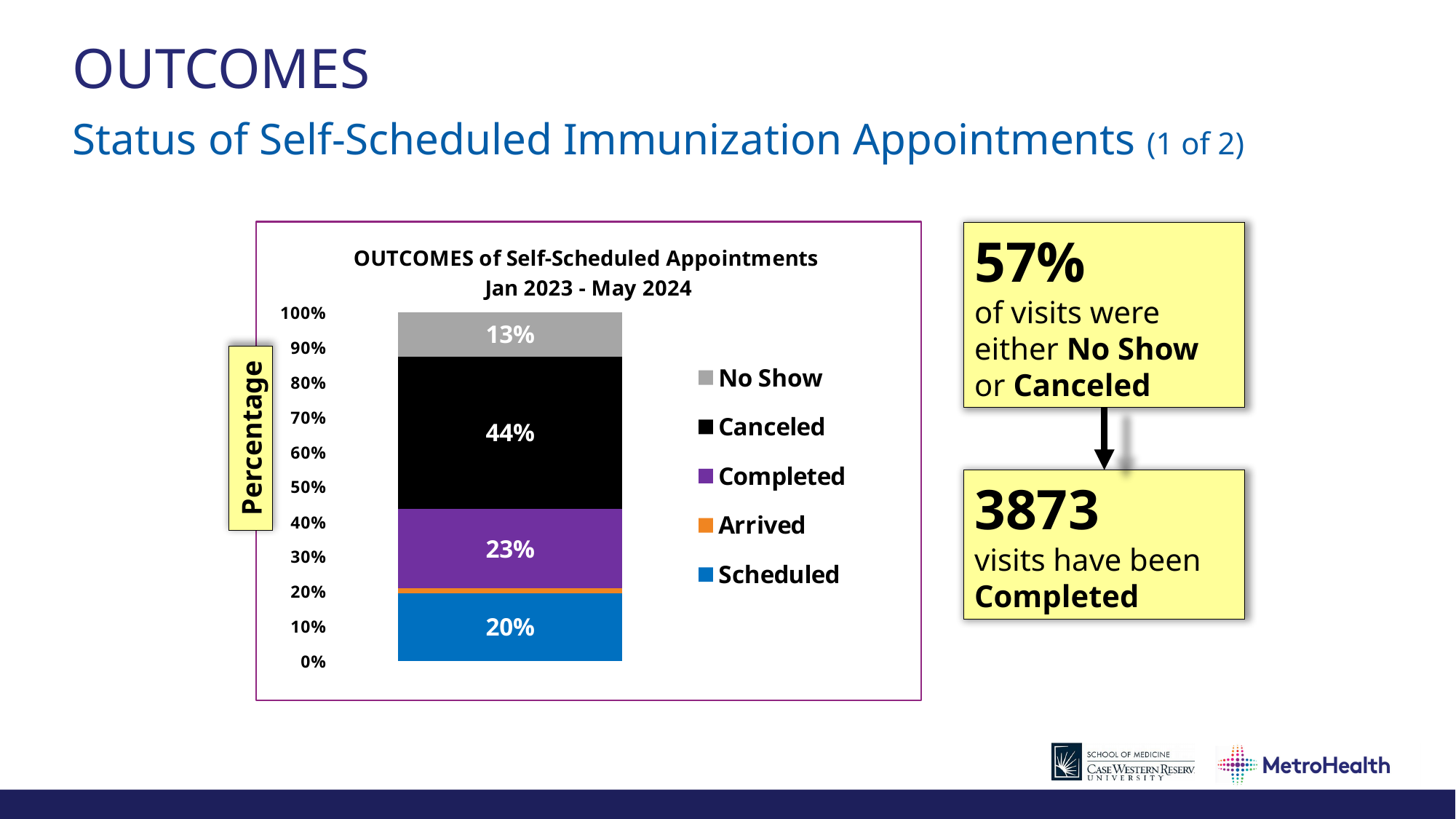
What is the difference between the Canceled share and the No Show share? 31% How many series does the chart legend list? 5 Which outcome category makes up the largest share of the stacked bar? Canceled What percentage of self-scheduled appointments were No Show? 13% How many percentage points larger is the Canceled share than the Completed share? 21% Is the Arrived share greater or less than 10%? less Which is larger, the Completed share or the Scheduled share? Completed What percentage of self-scheduled appointments were Canceled? 44% What type of chart is shown on the slide? Stacked bar chart What percentage of self-scheduled appointments were Scheduled? 20% Which outcome category makes up the smallest share of the stacked bar? Arrived What percentage of self-scheduled appointments were Completed? 23%